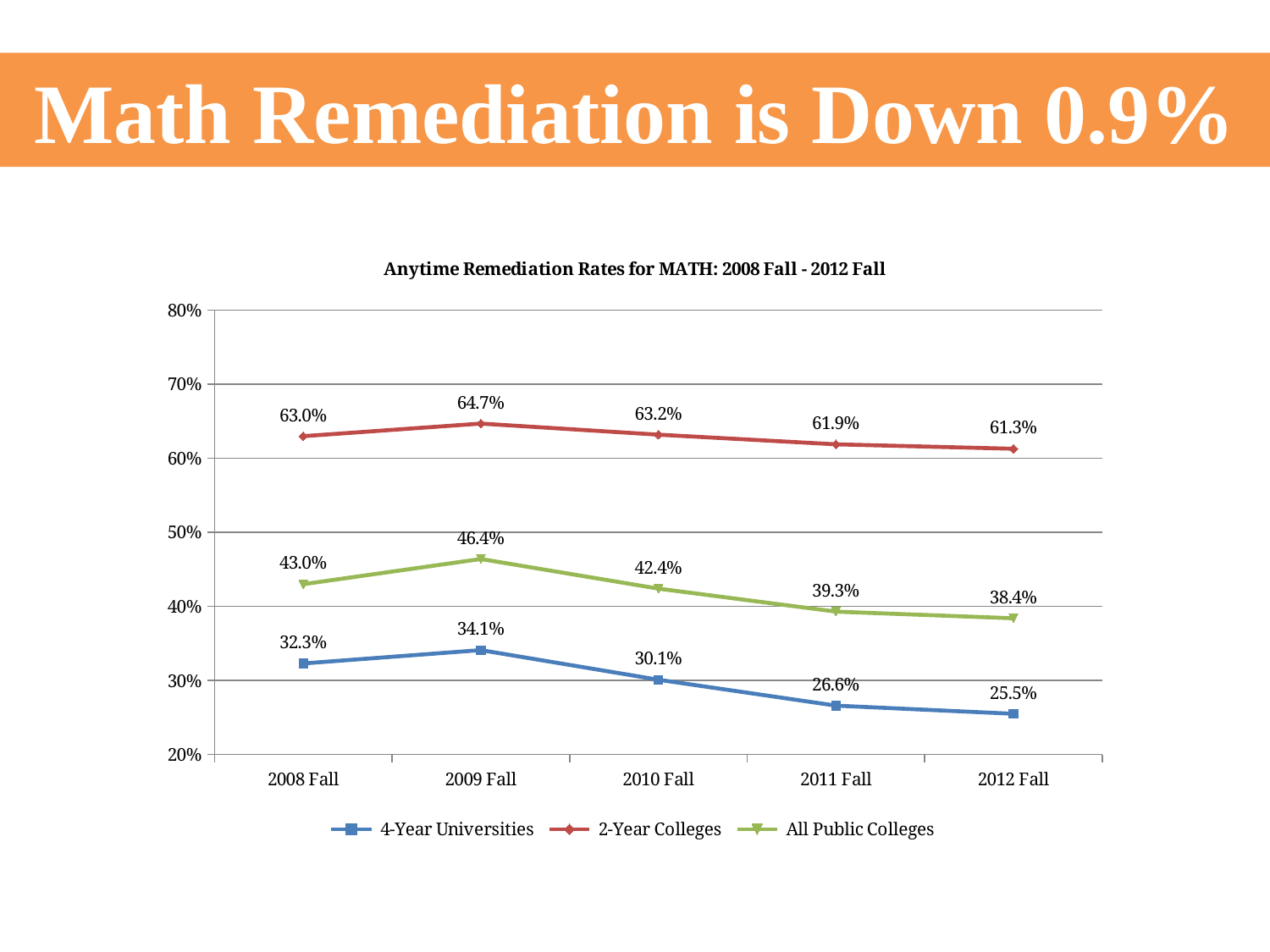
In which year is the 4-Year Universities value highest? 2009 Fall In which year is the All Public Colleges value lowest? 2012 Fall What is the value for All Public Colleges in 2010 Fall? 42.4% How many time points are shown on the x axis? 5 What is the difference between the 2-Year Colleges value and the 4-Year Universities value in 2008 Fall? 30.7% How many series does the legend list? 3 What kind of chart is shown on the slide? line chart Which is larger in 2011 Fall: the value for 2-Year Colleges or the value for All Public Colleges? 2-Year Colleges Does the All Public Colleges series rise or fall from 2009 Fall to 2012 Fall? fall Is the value for 4-Year Universities in 2010 Fall greater or less than 40%? less What is the value for 2-Year Colleges in 2009 Fall? 64.7% What is the value for 4-Year Universities in 2012 Fall? 25.5%